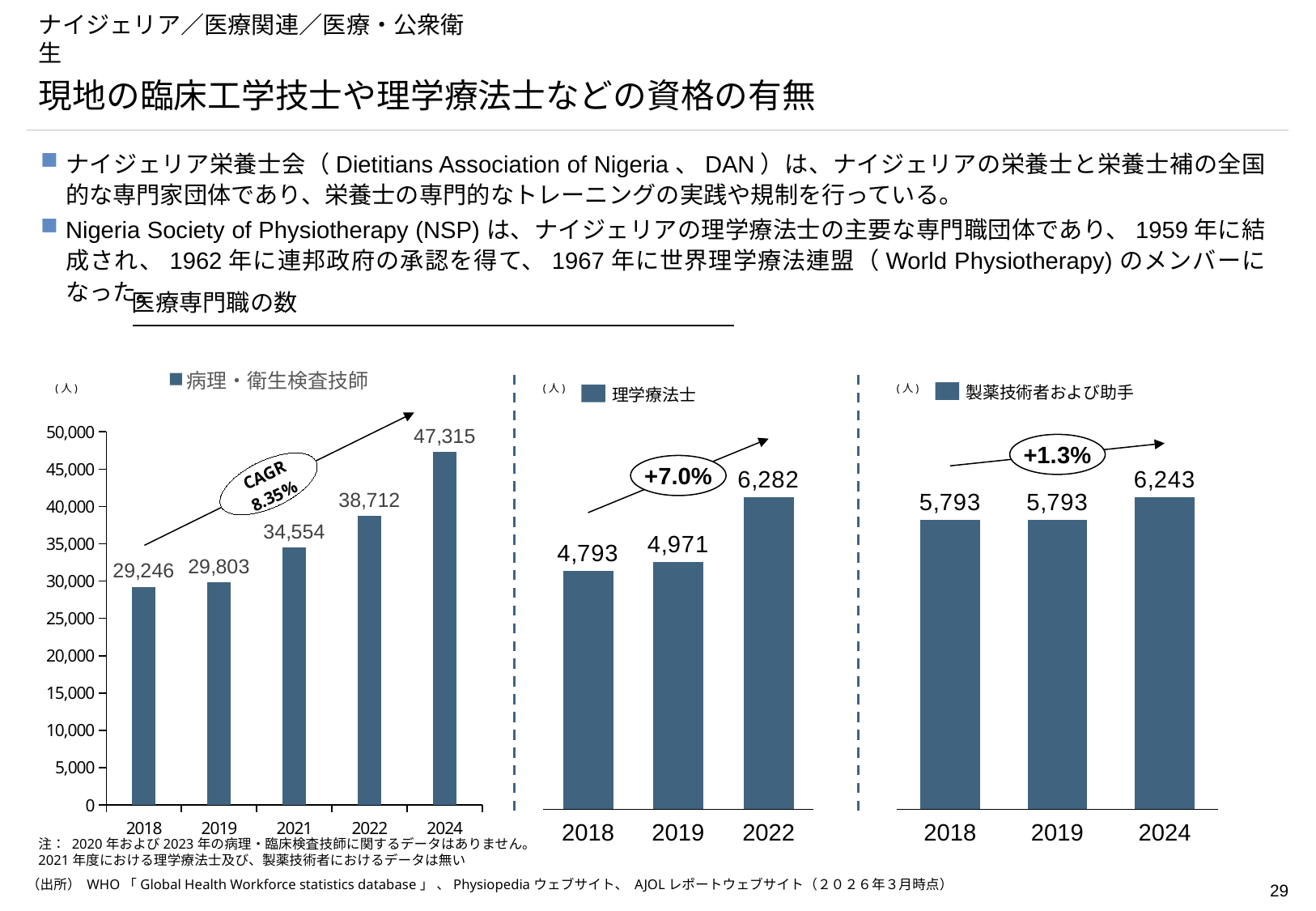
In the 製薬技術者および助手 chart (right), which is larger, the value for 2024 or the value for 2019? 2024 In the 製薬技術者および助手 chart (right), what is the value for 2024? 6,243 In the 理学療法士 chart (middle), what is the difference between the 2019 and 2018 values? 178 In the 病理・衛生検査技師 chart (left), what is the difference between the 2024 and 2022 values? 8,603 In the 病理・衛生検査技師 chart (left), do the values rise or fall from 2018 to 2024? rise In the 病理・衛生検査技師 chart (left), what is the value for 2021? 34,554 What CAGR is annotated on the 病理・衛生検査技師 chart (left)? 8.35% In the 病理・衛生検査技師 chart (left), how many years are plotted? 5 What kind of chart is the 理学療法士 chart (middle)? bar chart In the 病理・衛生検査技師 chart (left), what is the value for 2024? 47,315 In the 理学療法士 chart (middle), what is the value for 2022? 6,282 In the 病理・衛生検査技師 chart (left), which year has the lowest value? 2018